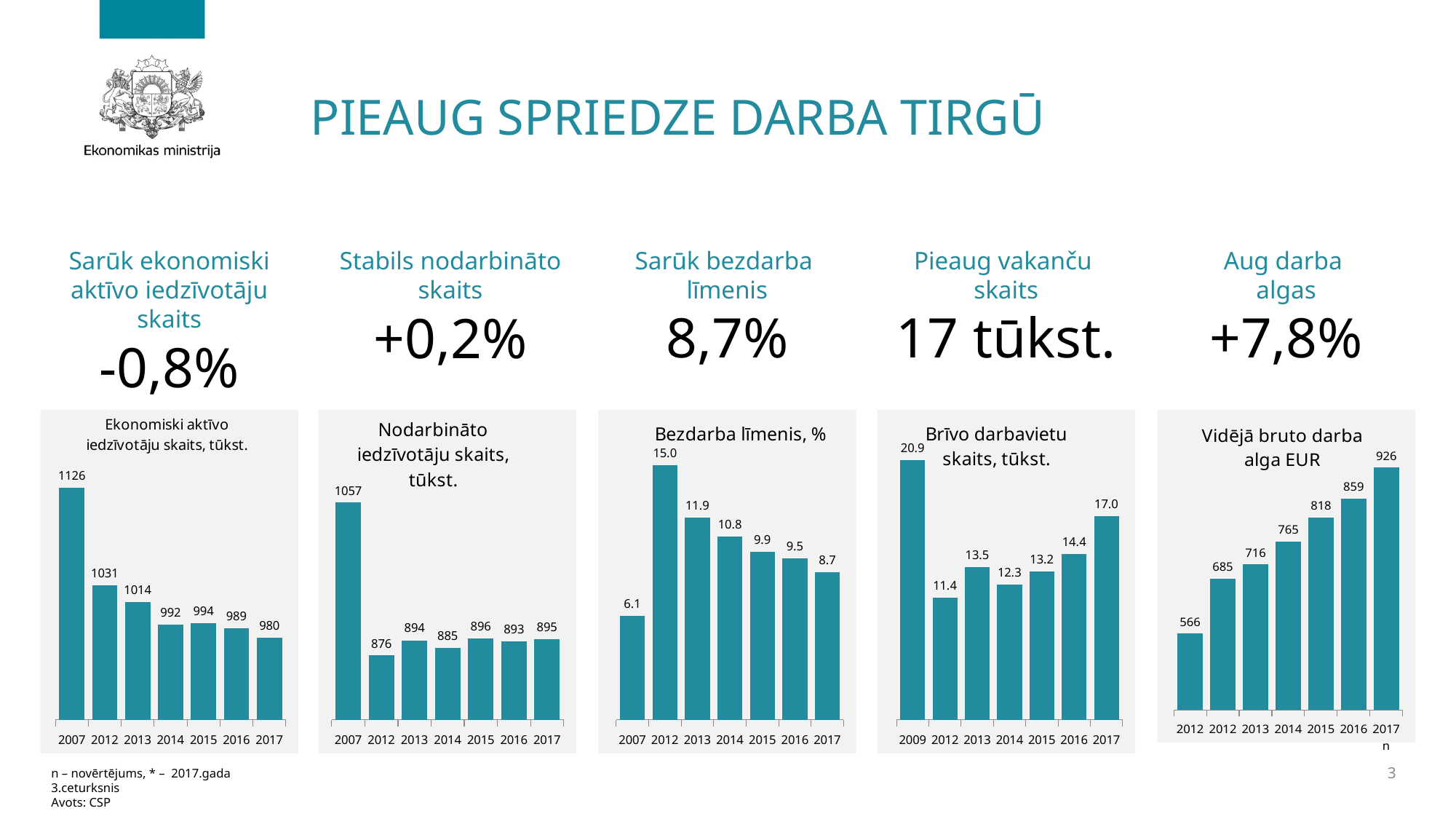
In the chart titled 'Vidējā bruto darba alga EUR', what is the value for 2017? 926 In the chart titled 'Brīvo darbavietu skaits, tūkst.', which is larger, the value for 2013 or the value for 2015? 2013 In the chart titled 'Bezdarba līmenis, %', what is the value for 2012? 15.0 What type of chart is the chart titled 'Vidējā bruto darba alga EUR'? bar chart In the chart titled 'Ekonomiski aktīvo iedzīvotāju skaits, tūkst.', which year has the highest value? 2007 In the chart titled 'Nodarbināto iedzīvotāju skaits, tūkst.', what is the difference between the 2007 value and the 2017 value? 162 In the chart titled 'Ekonomiski aktīvo iedzīvotāju skaits, tūkst.', what is the value for 2017? 980 In the chart titled 'Bezdarba līmenis, %', do the values rise or fall from 2012 to 2017? fall In the chart titled 'Nodarbināto iedzīvotāju skaits, tūkst.', what is the value for 2012? 876 In the chart titled 'Brīvo darbavietu skaits, tūkst.', what is the value for 2016? 14.4 In the chart titled 'Bezdarba līmenis, %', which year has the lowest value? 2007 In the chart titled 'Vidējā bruto darba alga EUR', how many bars are plotted? 7